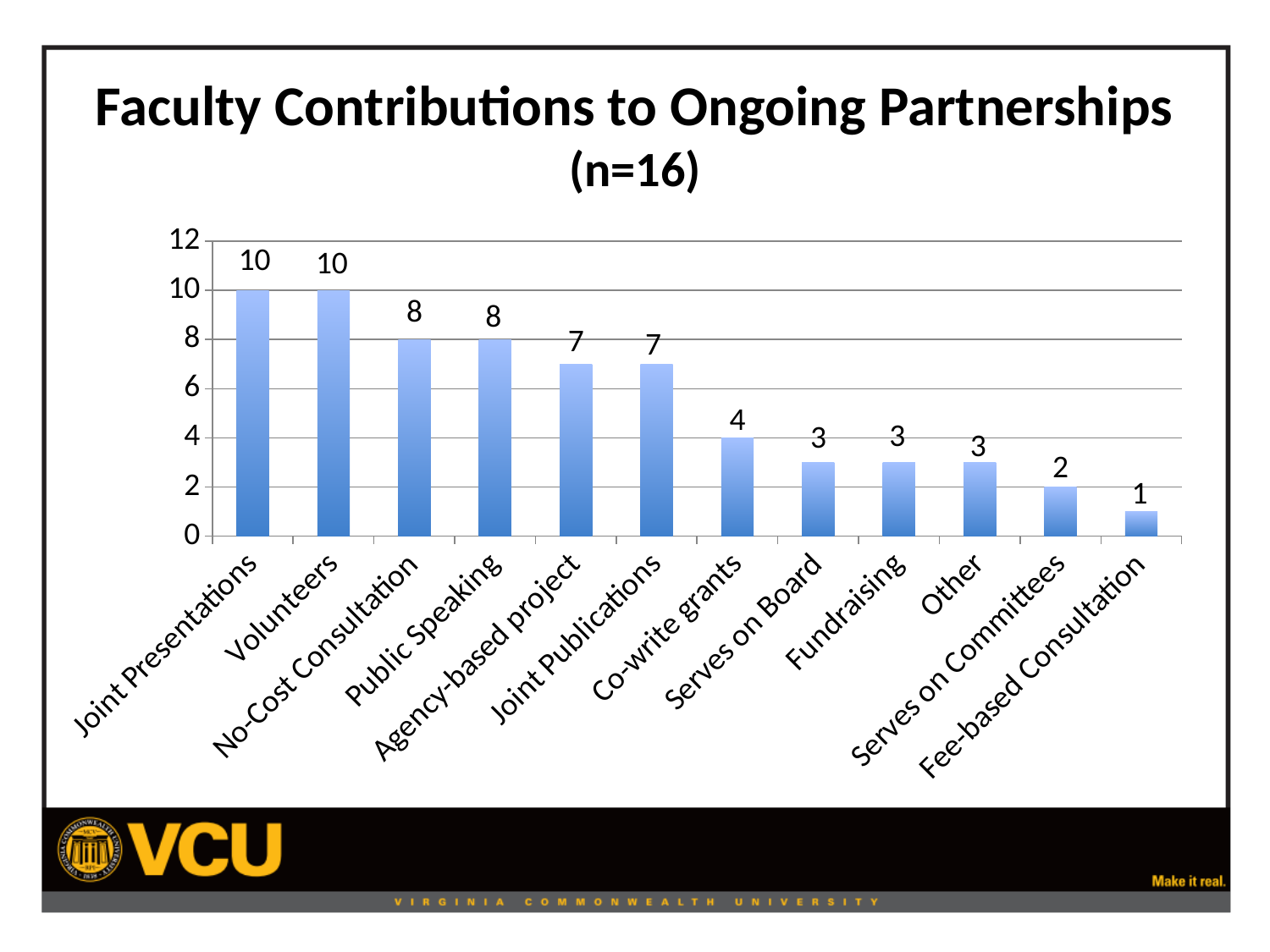
What kind of chart is shown on the slide? bar chart What is the difference between the values for No-Cost Consultation and Fee-based Consultation? 7 What is the difference between the values for Joint Presentations and Joint Publications? 3 Do the values rise or fall from left to right along the x axis? fall Which is larger, the value for Agency-based project or the value for Serves on Board? Agency-based project What is the title of the chart? Faculty Contributions to Ongoing Partnerships (n=16) How many categories are shown on the x axis? 12 Is the value for Volunteers greater or less than 6? greater Which category has the lowest value? Fee-based Consultation What is the value for Co-write grants? 4 What is the value for Public Speaking? 8 What is the value for Serves on Committees? 2